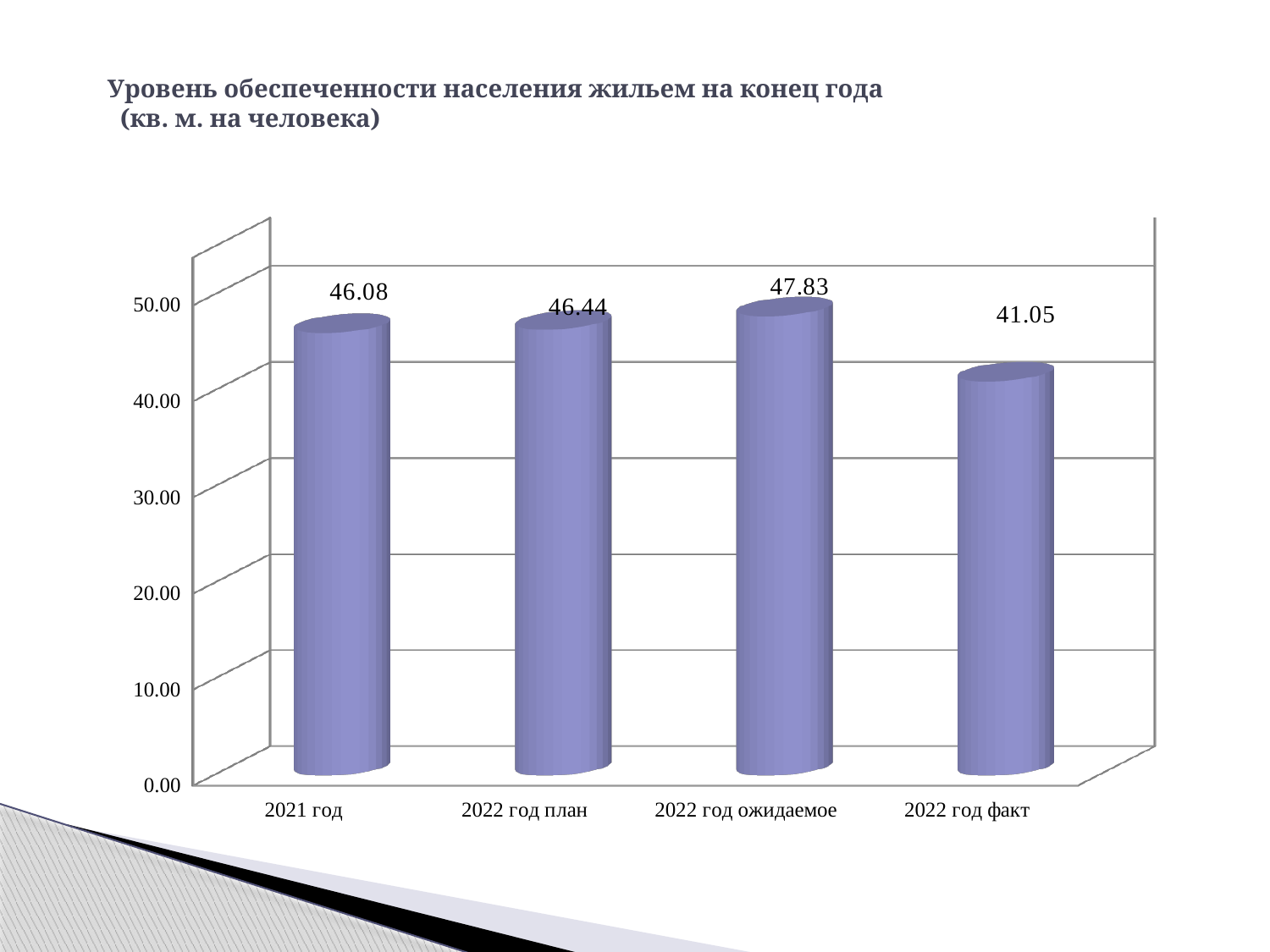
What is the value for 2022 год план? 46.44 Which is larger, the value for 2021 год or the value for 2022 год факт? 2021 год What is the difference between the values for 2022 год ожидаемое and 2022 год факт? 6.78 What is the value for 2021 год? 46.08 What is the value for 2022 год ожидаемое? 47.83 What is the difference between the values for 2022 год план and 2021 год? 0.36 Is the value for 2022 год факт greater or less than 40.00? greater Which category has the lowest value? 2022 год факт Which category has the highest value? 2022 год ожидаемое What is the value for 2022 год факт? 41.05 What kind of chart is shown on the slide? bar chart How many categories are shown on the x axis? 4